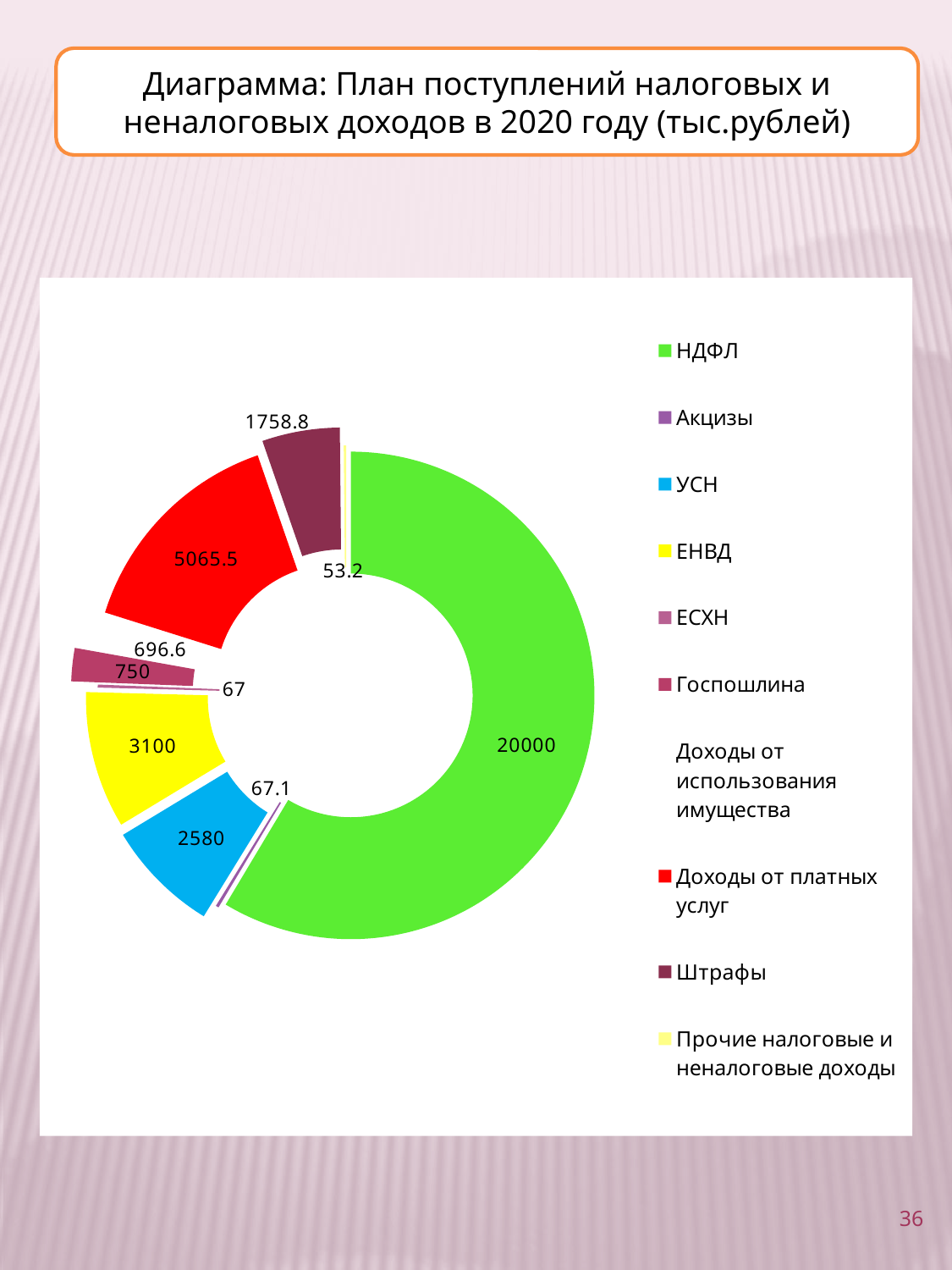
What is the value shown for УСН? 2580 Which is larger, the value for ЕНВД or the value for УСН? ЕНВД How many categories does the legend list? 10 Which category has the largest value in the chart? НДФЛ Which category has the smallest value in the chart? Прочие налоговые и неналоговые доходы What type of chart is shown on the slide? Doughnut (pie) chart What is the planned value for НДФЛ? 20000 What is the difference between the values for Доходы от платных услуг and ЕНВД? 1965.5 What is the value shown for Доходы от платных услуг? 5065.5 What is the value shown for ЕНВД? 3100 What is the value shown for Штрафы? 1758.8 What is the value shown for Госпошлина? 750